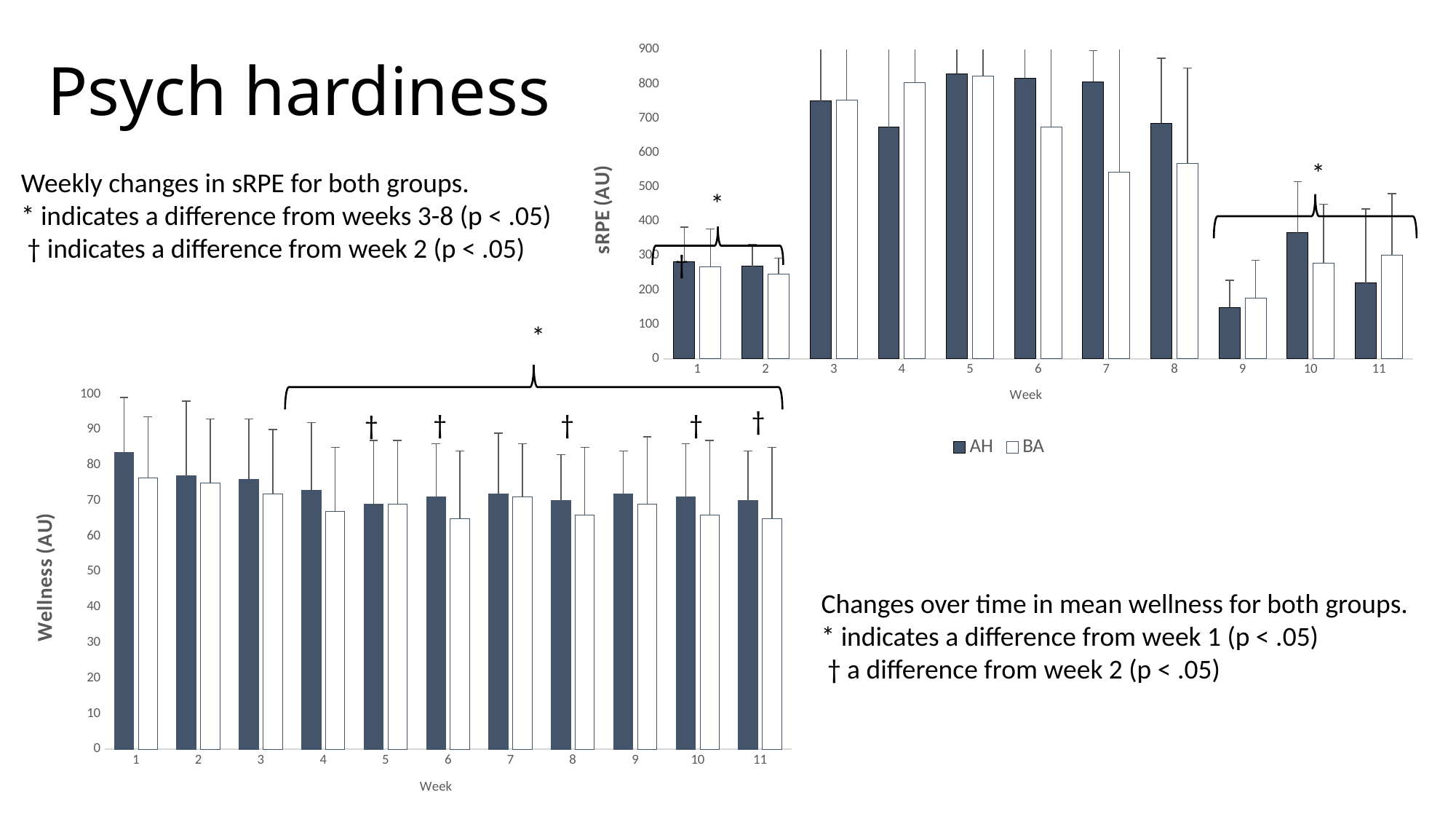
In the Wellness (AU) chart, is the BA value for week 4 greater or less than 70? less How many series does the legend list for the charts on the slide? 2 How many weeks are shown on the x axis of the Wellness (AU) chart at the bottom left? 11 What kind of chart is the sRPE (AU) chart at the top right of the slide? bar chart In the Wellness (AU) chart, is the AH value for week 1 greater or less than 80? greater In the Wellness (AU) chart, which week has the highest AH value? 1 In the sRPE (AU) chart, is the AH value for week 9 greater or less than 200? less In the sRPE (AU) chart, which is larger at week 7, the AH value or the BA value? AH What is the label on the x axis of the Wellness (AU) chart? Week In the sRPE (AU) chart, which week has the lowest AH value? 9